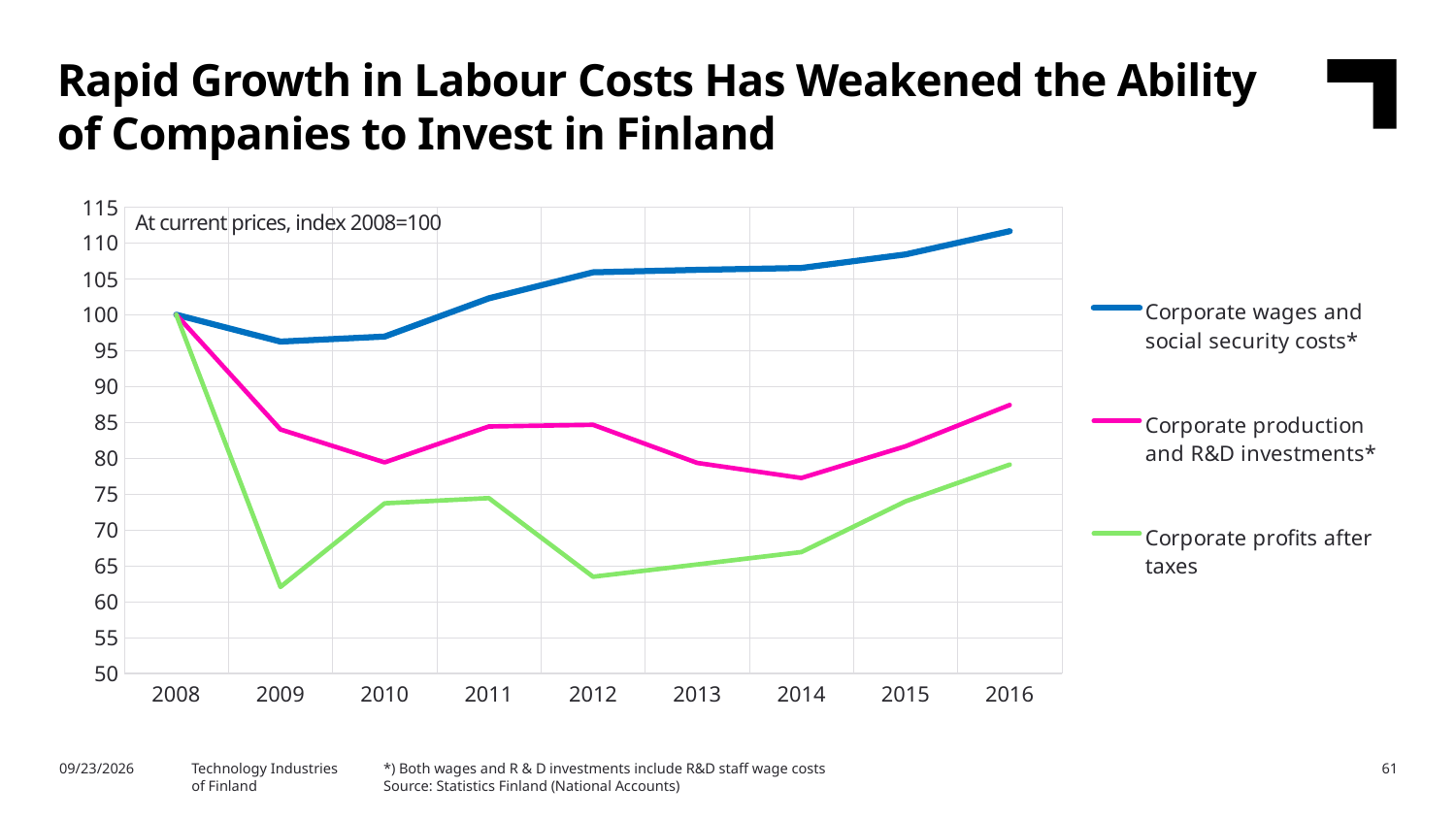
What is the index value for Corporate wages and social security costs* in 2008? 100 Is the value for Corporate profits after taxes in 2009 greater or less than 65? less How many years are shown on the x axis? 9 In 2012, which is higher: Corporate production and R&D investments* or Corporate profits after taxes? Corporate production and R&D investments* In which year does Corporate profits after taxes reach its lowest value? 2009 Which series has the highest value in 2016? Corporate wages and social security costs* What note is printed inside the chart area at the top left? At current prices, index 2008=100 Is the value for Corporate wages and social security costs* in 2016 greater or less than 110? greater What kind of chart is shown on the slide? Line chart How many series does the legend list? 3 Is the value for Corporate production and R&D investments* in 2014 greater or less than 80? less Do the values for Corporate wages and social security costs* rise or fall from 2010 to 2016? rise